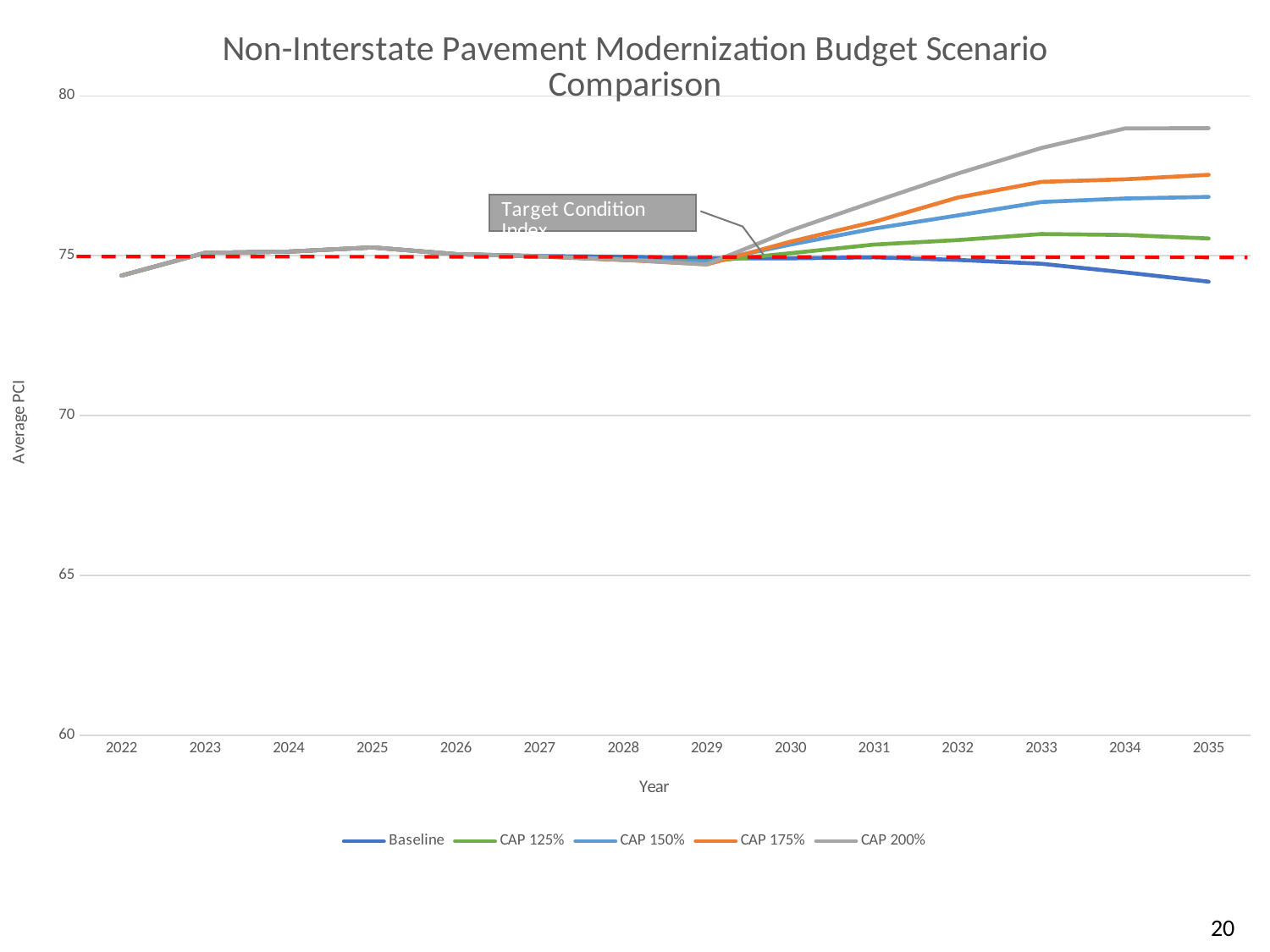
Is the value for CAP 200% in 2035 greater or less than 75? greater How many series does the legend list? 5 Is the value for CAP 200% in 2034 greater or less than 80? less Does the CAP 200% series rise or fall from 2029 to 2034? rise How many years are shown along the x axis? 14 Which series has the lowest value in 2035? Baseline Which series has the highest value in 2035? CAP 200% What is the label of the y axis? Average PCI What kind of chart is shown on the slide? line chart Does the Baseline series rise or fall from 2031 to 2035? fall In 2035, which is larger: CAP 175% or CAP 150%? CAP 175% Is the value for Baseline in 2035 greater or less than 75? less